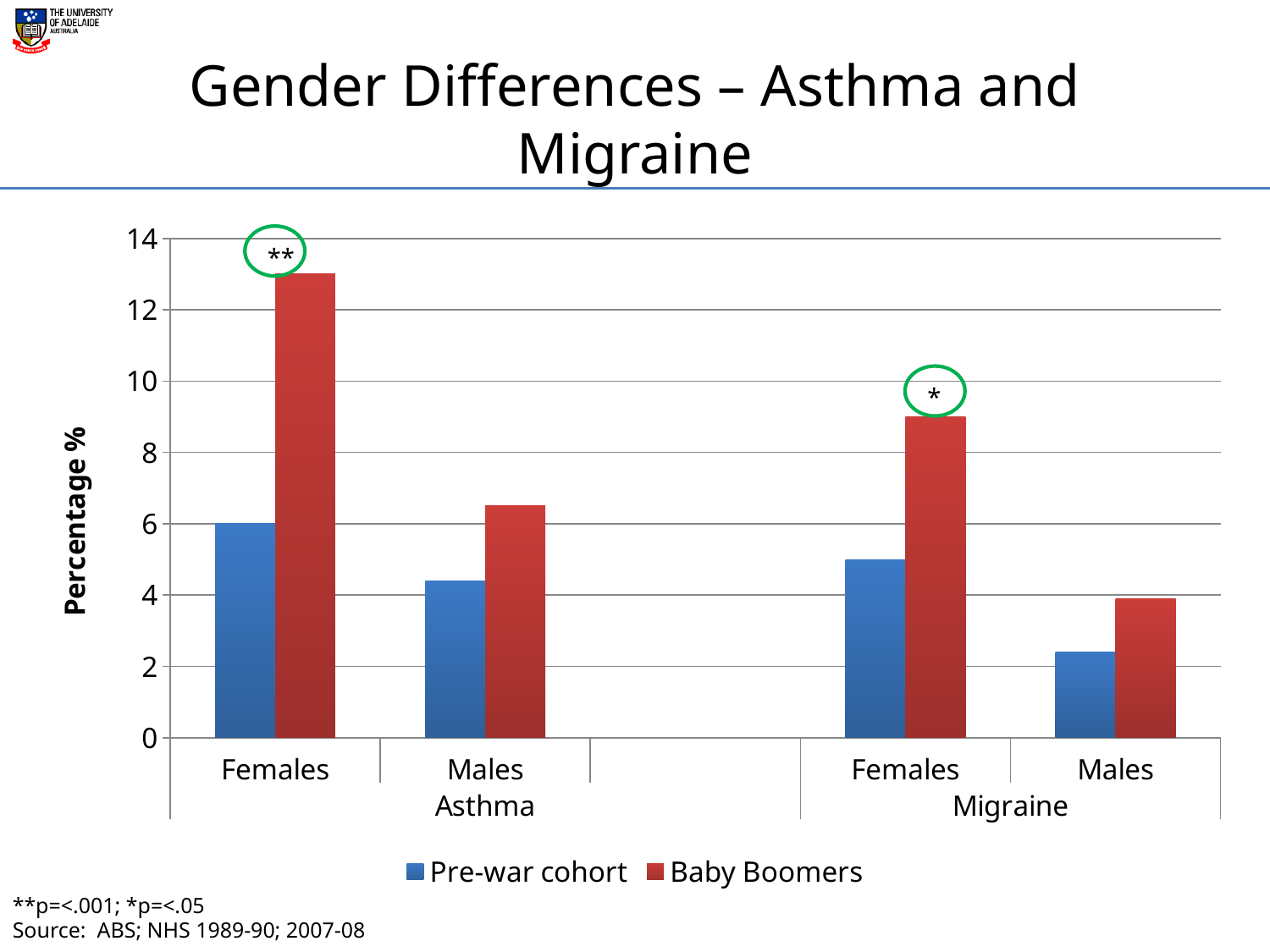
For Females under Migraine, which is larger: the Pre-war cohort or the Baby Boomers value? Baby Boomers Which bar is the lowest in the chart? Pre-war cohort, Males, Migraine Is the Baby Boomers value for Females under Asthma greater or less than 12? greater What is the label on the vertical axis? Percentage % What kind of chart is shown on the slide? bar chart What is the Pre-war cohort value for Females under Asthma? 6 How many category groups (gender bars pairs) are shown along the x axis? 4 What are the two series named in the legend? Pre-war cohort and Baby Boomers Is the Baby Boomers value for Females under Migraine greater or less than 8? greater How many series does the legend list? 2 Is the Pre-war cohort value for Males under Migraine greater or less than 4? less Which bar is the highest in the chart? Baby Boomers, Females, Asthma